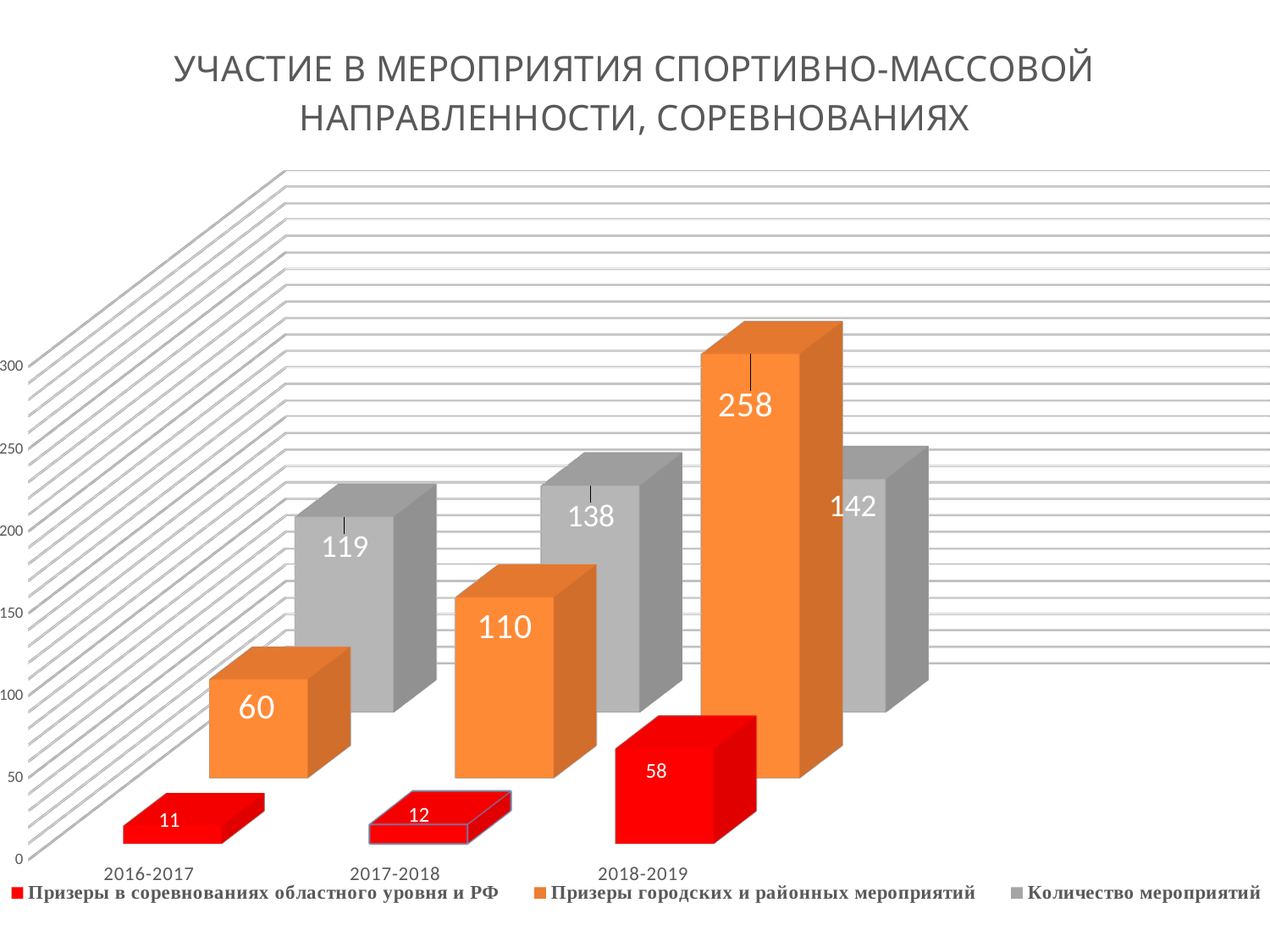
What is the value for 'Призеры городских и районных мероприятий' in 2018-2019? 258 What is the difference between 'Призеры городских и районных мероприятий' in 2018-2019 and 2017-2018? 148 Which colour represents 'Призеры в соревнованиях областного уровня и РФ' in the legend? red Do the values for 'Количество мероприятий' rise or fall from 2016-2017 to 2018-2019? rise In which period is 'Призеры в соревнованиях областного уровня и РФ' lowest? 2016-2017 In which period is 'Призеры городских и районных мероприятий' highest? 2018-2019 Which is larger in 2017-2018: 'Призеры городских и районных мероприятий' or 'Количество мероприятий'? Количество мероприятий What is the value for 'Количество мероприятий' in 2016-2017? 119 What kind of chart is shown on the slide? bar chart How many series does the legend list? 3 What is the value for 'Призеры в соревнованиях областного уровня и РФ' in 2017-2018? 12 How many periods are shown on the x axis? 3